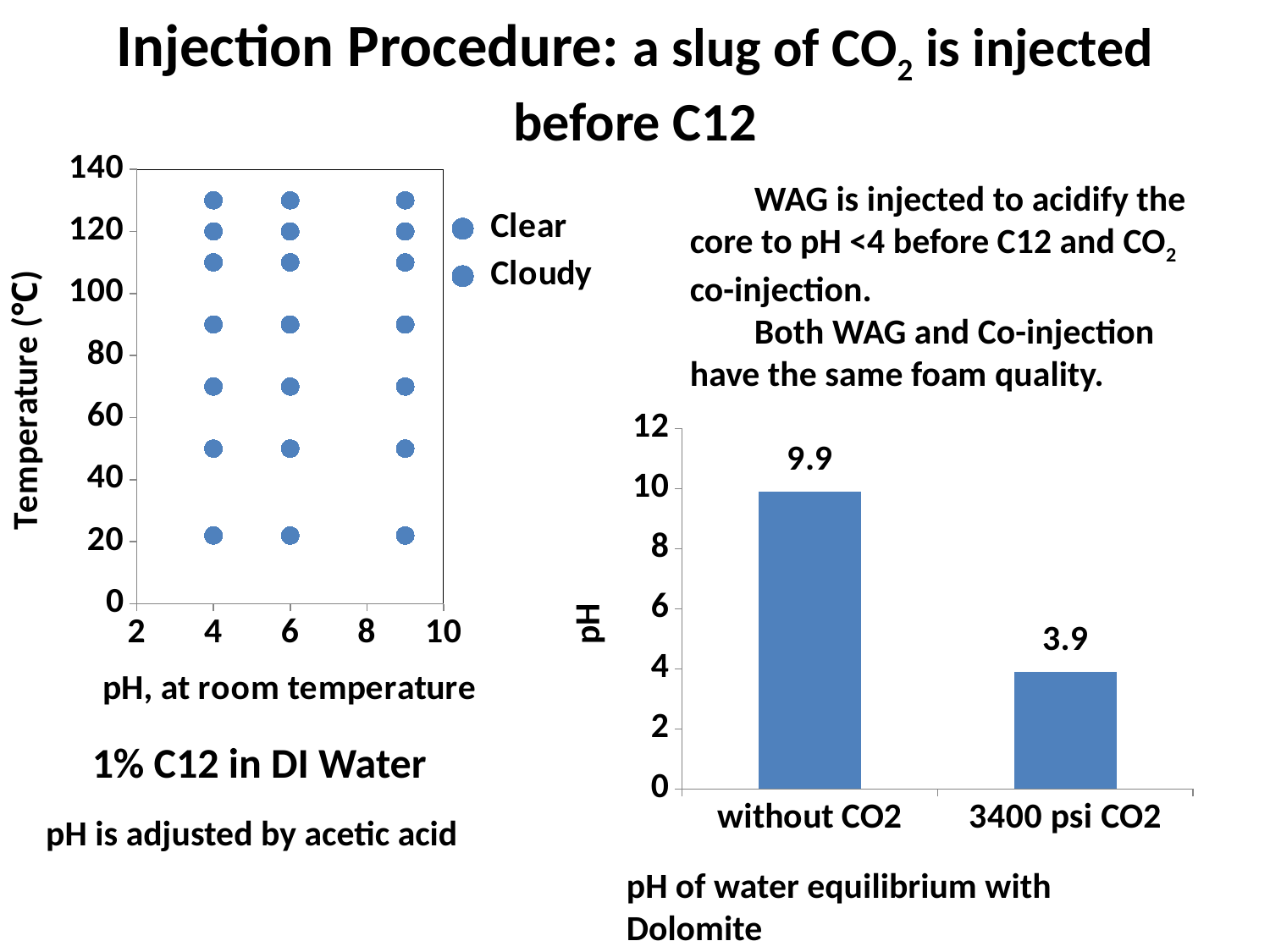
How many series does the legend of the left chart list? 2 What is the y-axis label of the left chart? Temperature (°C) What kind of chart is the chart on the right of the slide? bar chart On the bar chart on the right, which category has the lowest pH? 3400 psi CO2 What kind of chart is the chart on the left of the slide? scatter chart On the bar chart on the right, what is the difference in pH between 'without CO2' and '3400 psi CO2'? 6.0 On the bar chart on the right, what is the pH value for 'without CO2'? 9.9 On the bar chart on the right, how many categories are shown on the x axis? 2 On the bar chart on the right, is the value for '3400 psi CO2' greater or less than 4? less On the left chart, how many distinct pH values have data points plotted? 3 On the bar chart on the right, what is the pH value for '3400 psi CO2'? 3.9 On the bar chart on the right, which category has the higher pH? without CO2